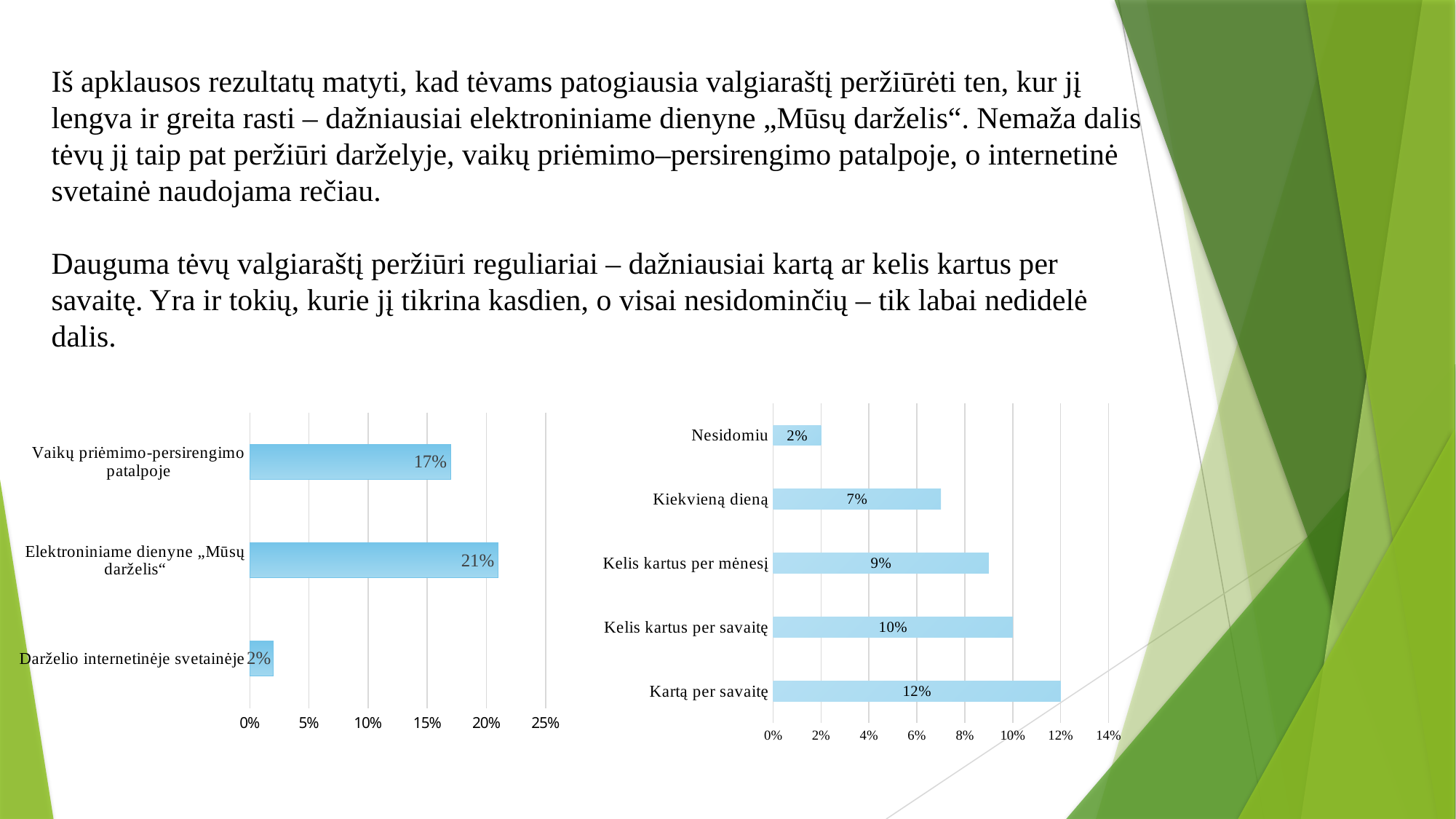
In the left chart, what is the value for "Darželio internetinėje svetainėje"? 2% In the right chart, which is larger: "Kiekvieną dieną" or "Kelis kartus per savaitę"? Kelis kartus per savaitę In the right chart, what is the value for "Kelis kartus per mėnesį"? 9% In the left chart, which category has the highest value? Elektroniniame dienyne „Mūsų darželis“ In the left chart, how many categories are shown? 3 In the left chart, what is the value for "Elektroniniame dienyne „Mūsų darželis“"? 21% In the right chart, how many categories are shown? 5 In the right chart, which category has the lowest value? Nesidomiu In the left chart, what is the difference between "Elektroniniame dienyne „Mūsų darželis“" and "Vaikų priėmimo-persirengimo patalpoje"? 4% In the right chart, what is the value for "Kartą per savaitę"? 12% What kind of chart is the left chart? Bar chart In the right chart, what is the difference between "Kartą per savaitę" and "Nesidomiu"? 10%